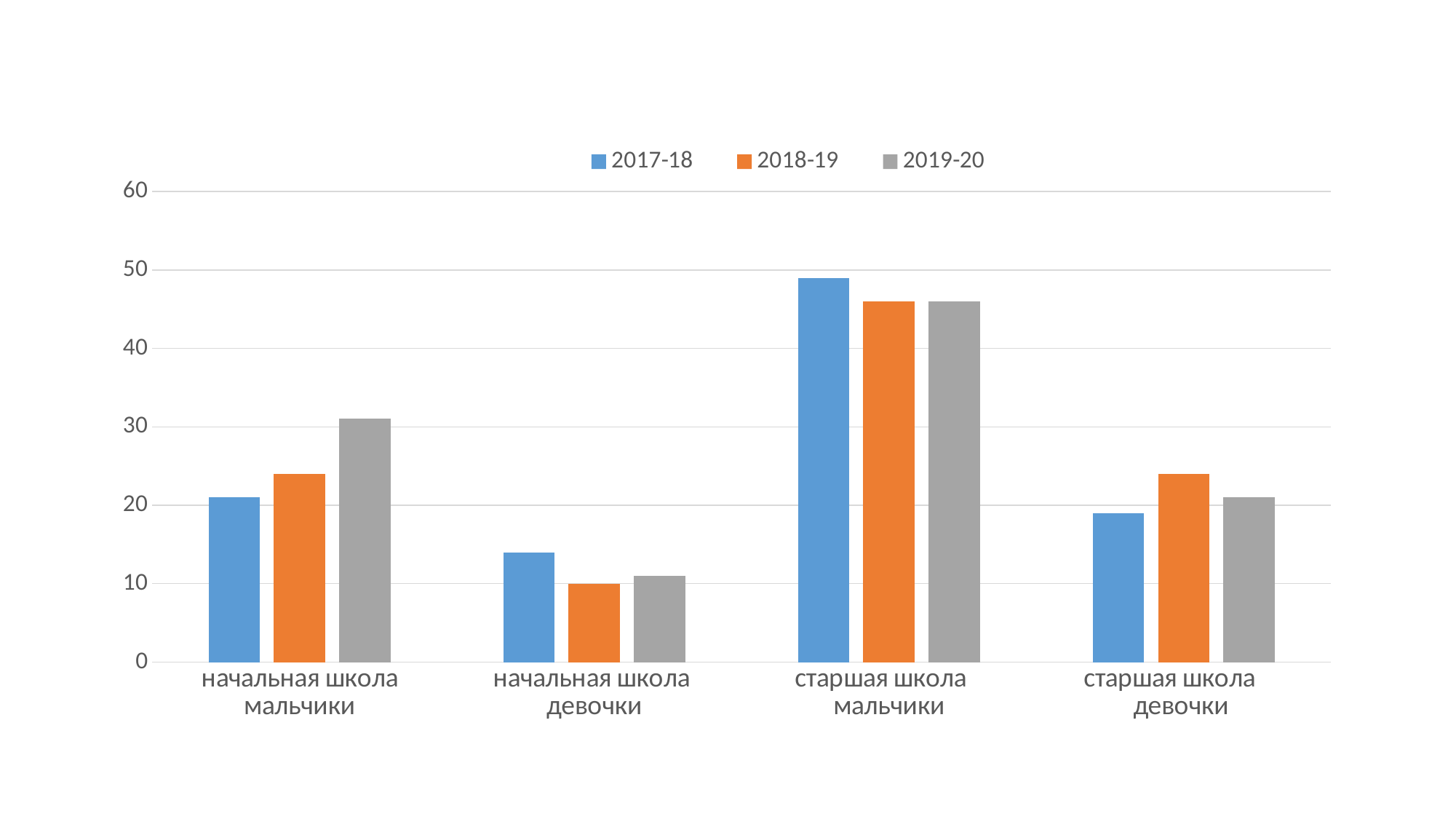
Which category has the tallest bar in the chart? старшая школа мальчики Which series is shown in orange in the legend? 2018-19 How many series does the legend list? 3 Is the 2017-18 value for старшая школа мальчики greater or less than 40? greater Is the 2018-19 value for старшая школа девочки greater or less than 20? greater Which category has the lowest values across all three series? начальная школа девочки For начальная школа мальчики, do the values rise or fall from 2017-18 to 2019-20? rise Is the 2017-18 value for начальная школа девочки greater or less than 20? less What kind of chart is shown on the slide? bar chart How many categories are shown on the x axis? 4 For начальная школа мальчики, which is larger: the 2017-18 value or the 2019-20 value? 2019-20